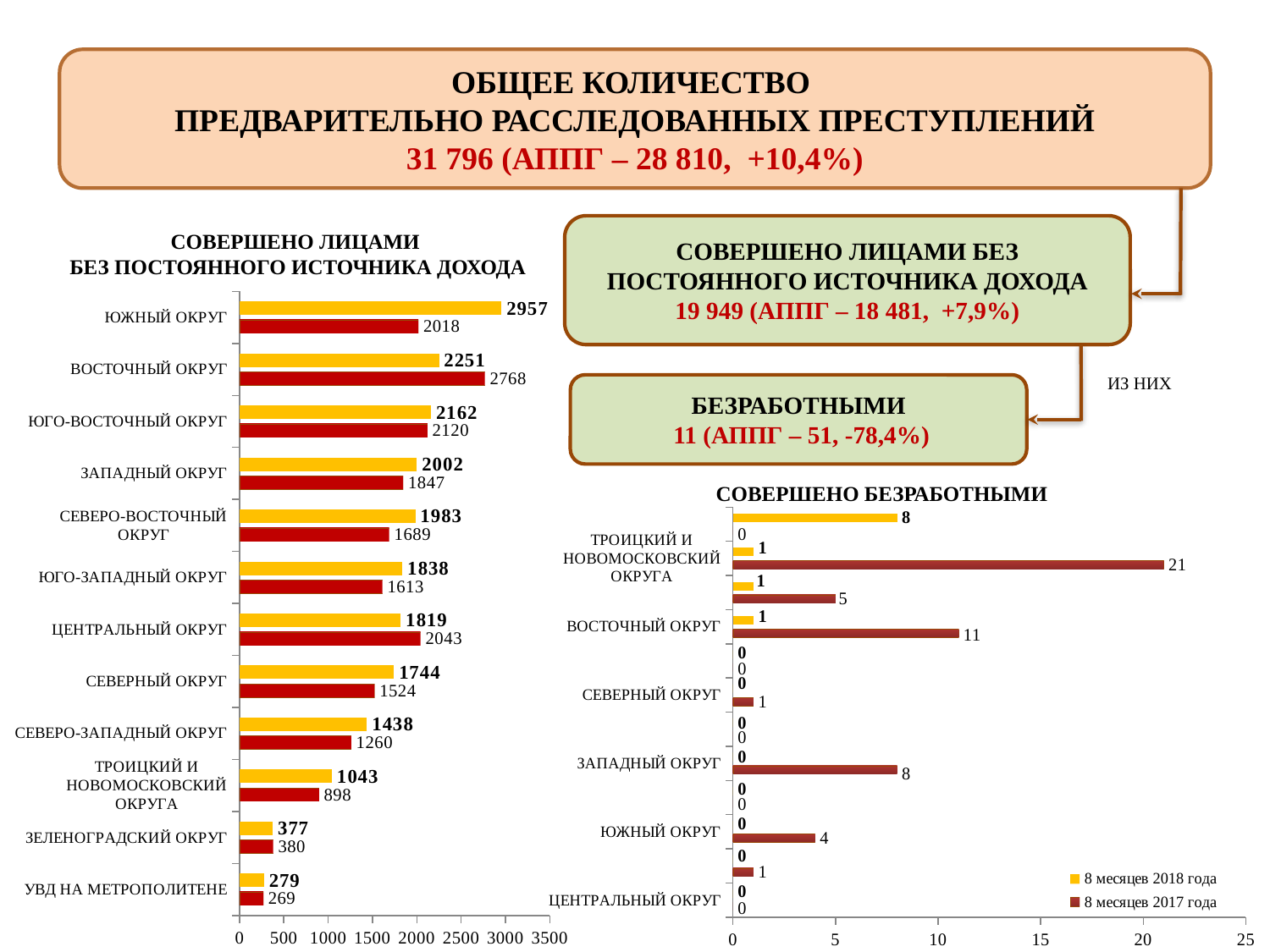
What is the largest value shown by any bar in the right chart 'СОВЕРШЕНО БЕЗРАБОТНЫМИ'? 21 In the left chart 'СОВЕРШЕНО ЛИЦАМИ БЕЗ ПОСТОЯННОГО ИСТОЧНИКА ДОХОДА', which category has the highest yellow bar value? ЮЖНЫЙ ОКРУГ In the left chart 'СОВЕРШЕНО ЛИЦАМИ БЕЗ ПОСТОЯННОГО ИСТОЧНИКА ДОХОДА', what is the value of the red bar for ВОСТОЧНЫЙ ОКРУГ? 2768 How many series does the legend of the right chart 'СОВЕРШЕНО БЕЗРАБОТНЫМИ' list? 2 In the left chart 'СОВЕРШЕНО ЛИЦАМИ БЕЗ ПОСТОЯННОГО ИСТОЧНИКА ДОХОДА', what is the value of the red bar for ЗЕЛЕНОГРАДСКИЙ ОКРУГ? 380 How many categories are shown in the left chart 'СОВЕРШЕНО ЛИЦАМИ БЕЗ ПОСТОЯННОГО ИСТОЧНИКА ДОХОДА'? 12 In the left chart 'СОВЕРШЕНО ЛИЦАМИ БЕЗ ПОСТОЯННОГО ИСТОЧНИКА ДОХОДА', what is the difference between the yellow and red bar values for ЮЖНЫЙ ОКРУГ? 939 What type of chart is used in the left chart titled 'СОВЕРШЕНО ЛИЦАМИ БЕЗ ПОСТОЯННОГО ИСТОЧНИКА ДОХОДА'? Bar chart In the left chart 'СОВЕРШЕНО ЛИЦАМИ БЕЗ ПОСТОЯННОГО ИСТОЧНИКА ДОХОДА', which is larger for ЦЕНТРАЛЬНЫЙ ОКРУГ: the yellow bar or the red bar? The red bar (2043) In the left chart 'СОВЕРШЕНО ЛИЦАМИ БЕЗ ПОСТОЯННОГО ИСТОЧНИКА ДОХОДА', what is the value of the yellow bar for ЮЖНЫЙ ОКРУГ? 2957 What are the two legend entries of the right chart 'СОВЕРШЕНО БЕЗРАБОТНЫМИ'? 8 месяцев 2018 года and 8 месяцев 2017 года In the left chart 'СОВЕРШЕНО ЛИЦАМИ БЕЗ ПОСТОЯННОГО ИСТОЧНИКА ДОХОДА', which category has the lowest yellow bar value? УВД НА МЕТРОПОЛИТЕНЕ